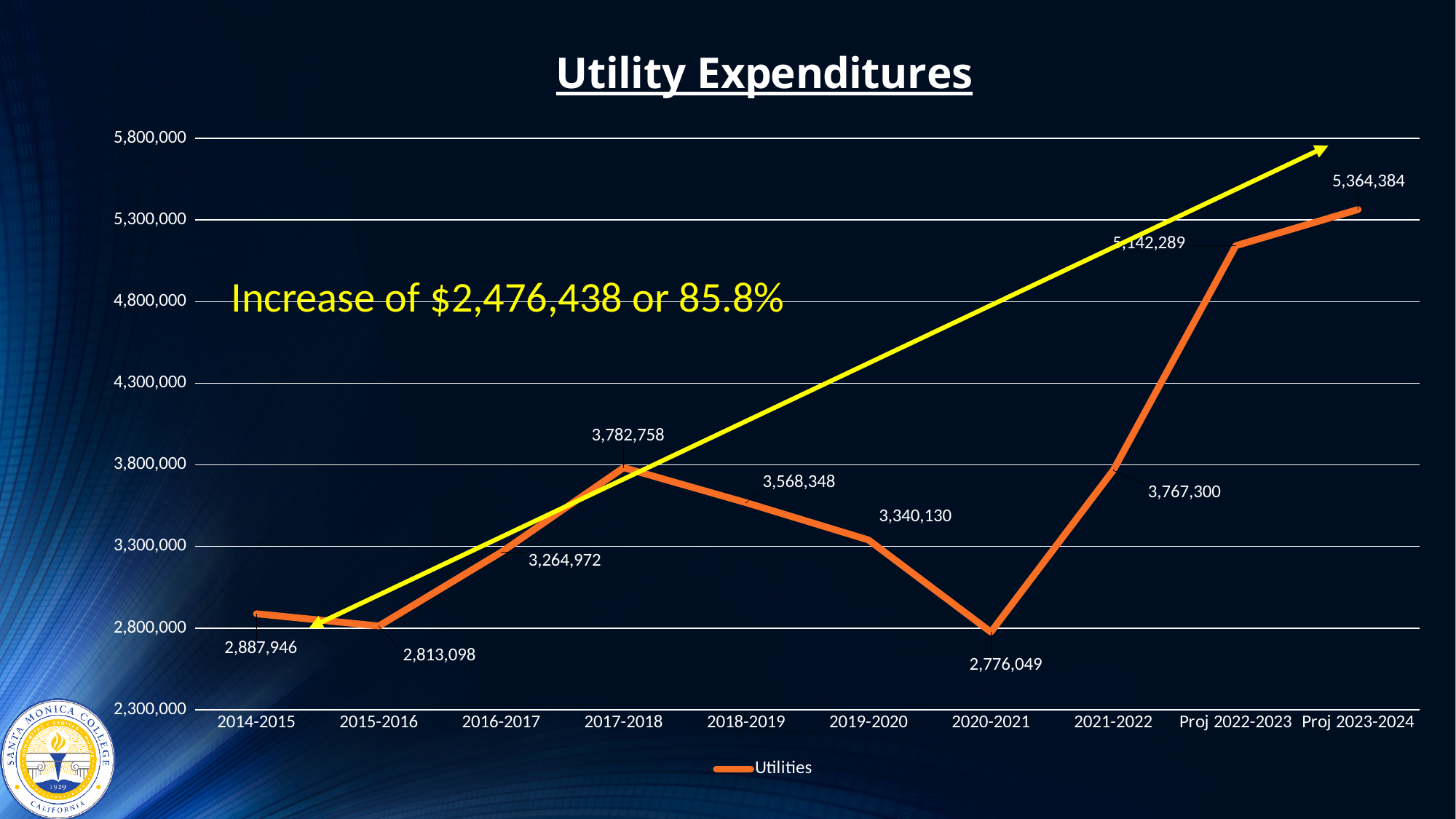
What is the difference between the values for Proj 2023-2024 and Proj 2022-2023? 222,095 How many years are plotted on the x axis? 10 What is the value for 2020-2021? 2,776,049 What is the value for 2017-2018? 3,782,758 Which is larger, the value for 2021-2022 or the value for 2017-2018? 2017-2018 Which year has the lowest utility expenditure? 2020-2021 Which year has the highest utility expenditure? Proj 2023-2024 What is the difference between the values for 2017-2018 and 2018-2019? 214,410 What is the value for 2016-2017? 3,264,972 What is the value for Proj 2023-2024? 5,364,384 What kind of chart is shown? Line chart What series name does the legend show? Utilities